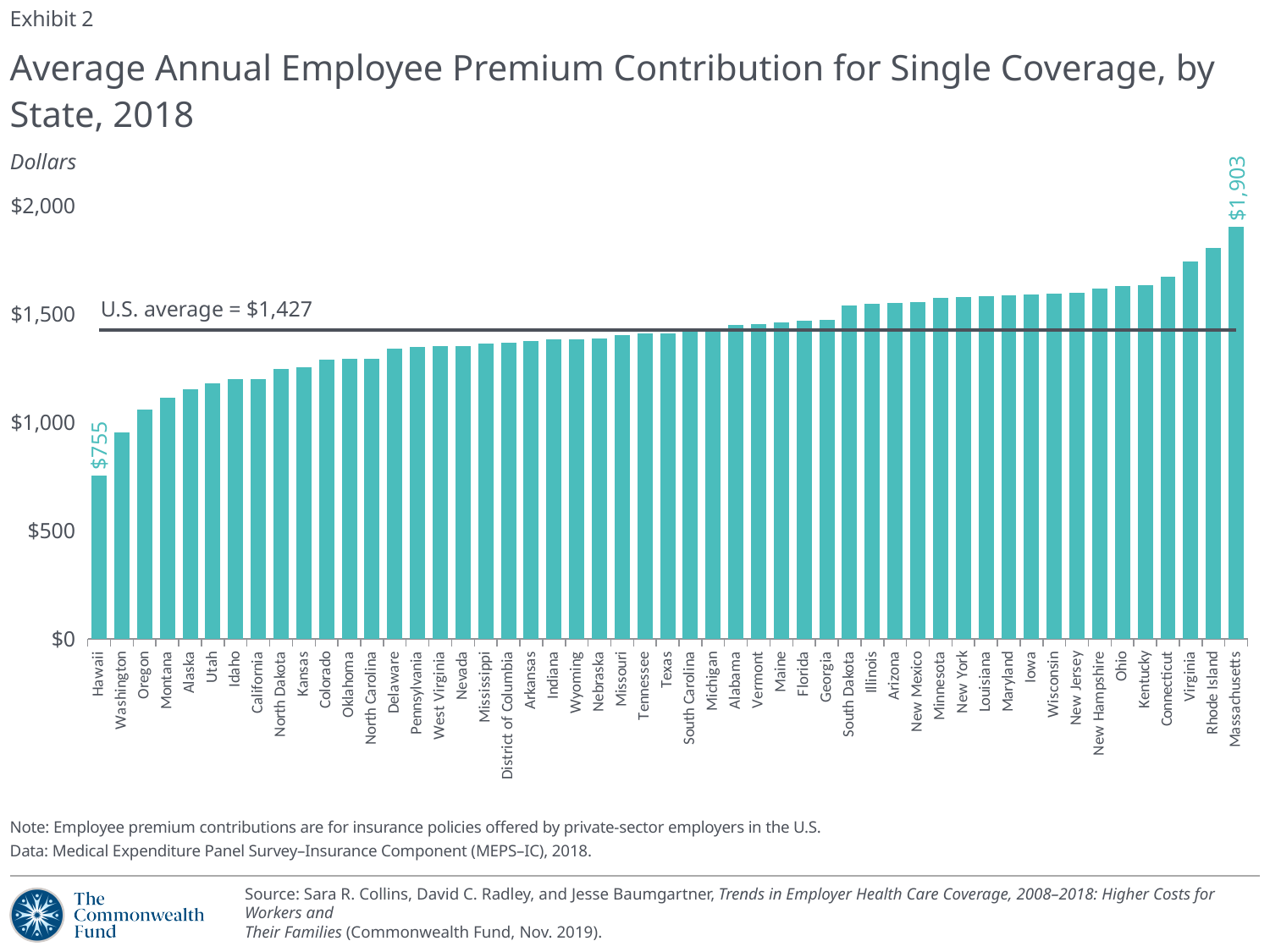
Which state has the lowest average annual employee premium contribution? Hawaii Which has a larger employee premium contribution, Oregon or Virginia? Virginia Is the value for Washington greater or less than $1,000? less Which state has the highest average annual employee premium contribution? Massachusetts Is the value for Rhode Island greater or less than $1,500? greater What is the difference between the employee premium contribution in Massachusetts and in Hawaii? $1,148 What is the average annual employee premium contribution for single coverage in Hawaii? $755 What kind of chart is shown on the slide? Bar chart Do the values rise or fall moving from left to right along the x axis? Rise What is the U.S. average employee premium contribution shown on the chart? $1,427 What is the average annual employee premium contribution for single coverage in Massachusetts? $1,903 How many states/jurisdictions are shown as bars on the chart? 51